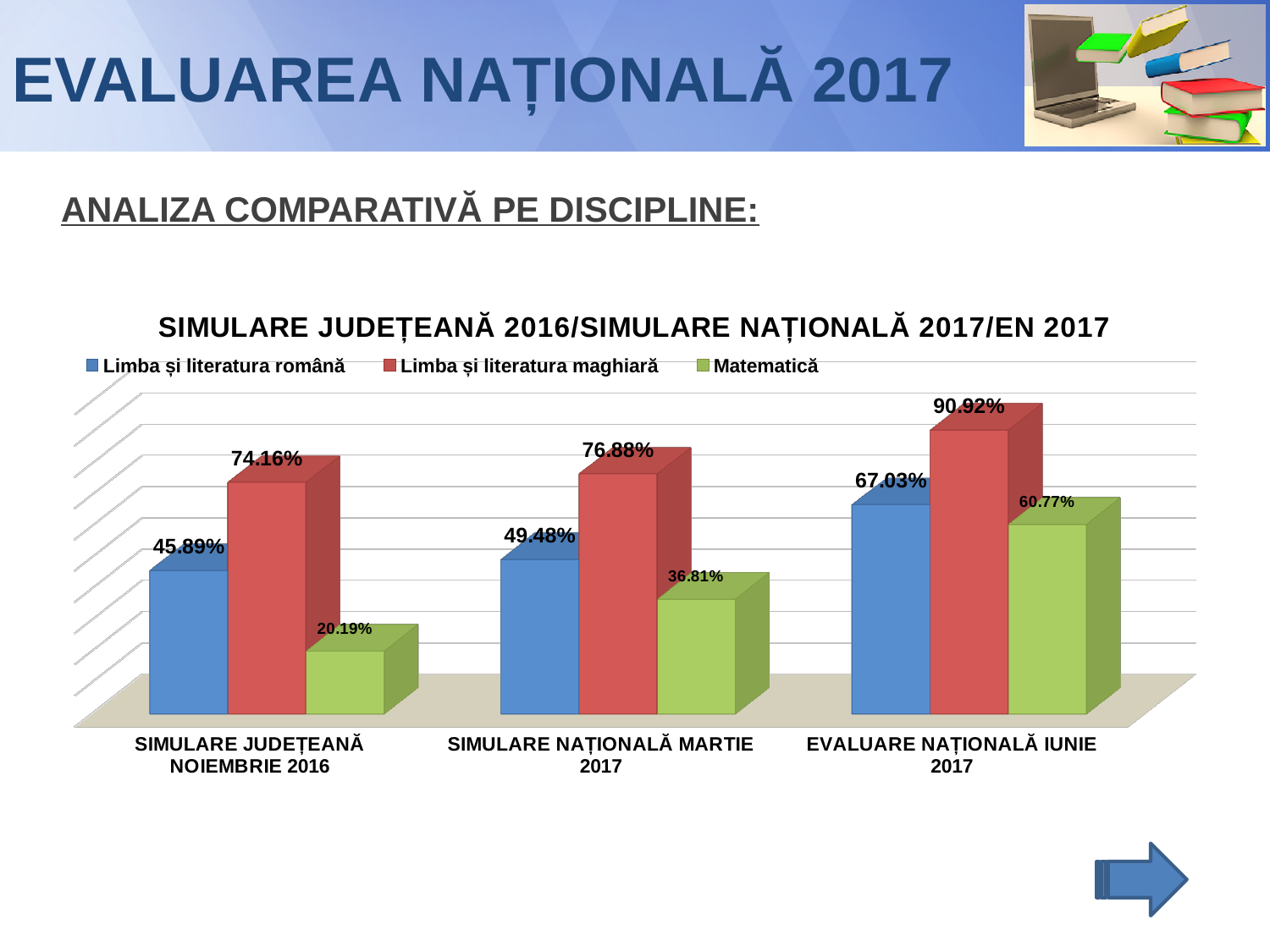
What kind of chart is shown on the slide? Bar chart Which is larger at EVALUARE NAȚIONALĂ IUNIE 2017: Limba și literatura română or Matematică? Limba și literatura română How many series does the legend list? 3 What is the value for Matematică at SIMULARE NAȚIONALĂ MARTIE 2017? 36.81% What is the value for Limba și literatura maghiară at EVALUARE NAȚIONALĂ IUNIE 2017? 90.92% Which category has the lowest value for Matematică? SIMULARE JUDEȚEANĂ NOIEMBRIE 2016 Do the Matematică values rise or fall from left to right across the categories? Rise What is the difference between the Limba și literatura maghiară value and the Limba și literatura română value at SIMULARE NAȚIONALĂ MARTIE 2017? 27.40% What is the value for Limba și literatura română at SIMULARE JUDEȚEANĂ NOIEMBRIE 2016? 45.89% Which category has the highest value for Limba și literatura maghiară? EVALUARE NAȚIONALĂ IUNIE 2017 How many categories are shown on the x axis? 3 What is the value for Matematică at EVALUARE NAȚIONALĂ IUNIE 2017? 60.77%